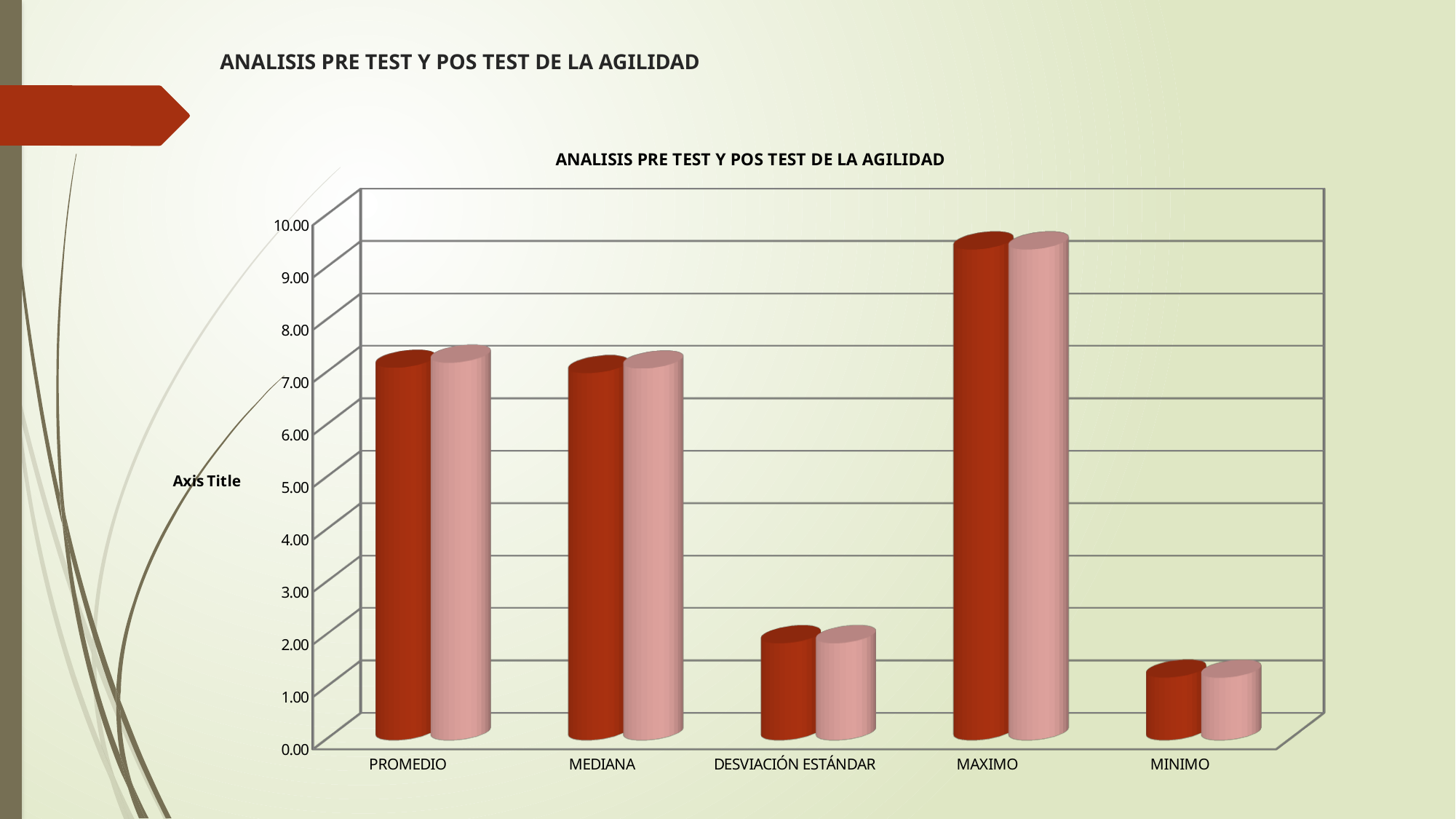
Is the pink bar for DESVIACIÓN ESTÁNDAR greater or less than 3.00? less Is the pink bar for MEDIANA greater or less than 5.00? greater Which category has the highest bars in the chart? MAXIMO What is the title of the chart? ANALISIS PRE TEST Y POS TEST DE LA AGILIDAD Which category has larger bars, PROMEDIO or DESVIACIÓN ESTÁNDAR? PROMEDIO Which category has the lowest bars in the chart? MINIMO Is the dark red bar for MAXIMO greater or less than 8.00? greater What is the label shown on the vertical axis of the chart? Axis Title How many categories are shown on the x axis of the chart? 5 What kind of chart is shown on the slide? bar chart